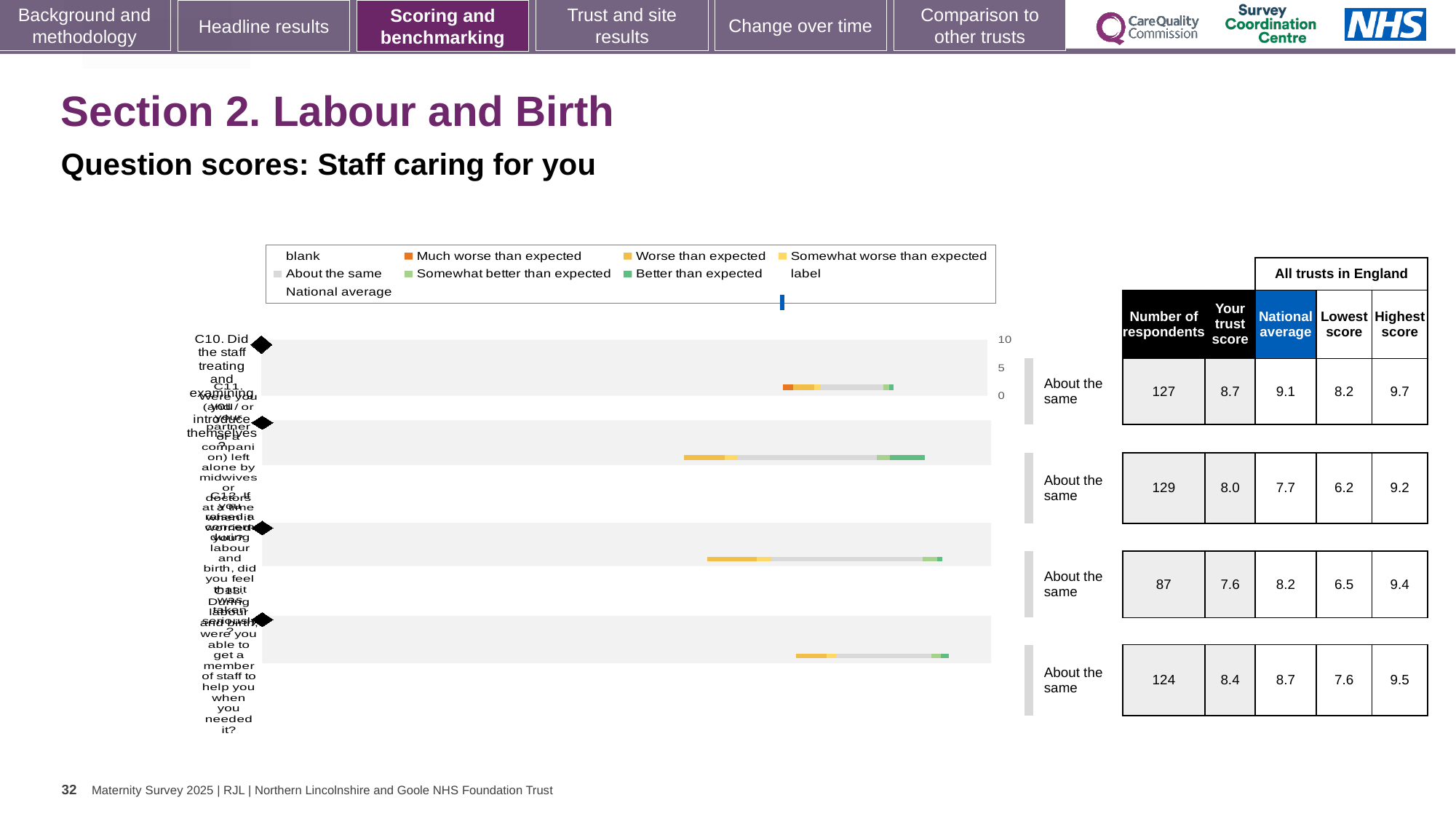
In the table beside the chart, what is the 'Your trust score' value for question C10? 8.7 How many questions (categories) are plotted in the chart? 4 What colour does the legend use for 'Better than expected'? green For question C11, which is larger: the trust score or the national average? the trust score What is the difference between the highest score and the lowest score for question C10 in the table? 1.5 In the table beside the chart, what is the highest score for question C13? 9.5 In the table beside the chart, how many respondents answered question C12? 87 What colour does the legend use for 'Much worse than expected'? orange Which question has the lowest 'Lowest score' value in the table beside the chart? C11 In the table beside the chart, what is the national average for question C11? 7.7 What kind of chart is shown on the slide? bar chart Which question has the largest number of respondents in the table beside the chart? C11